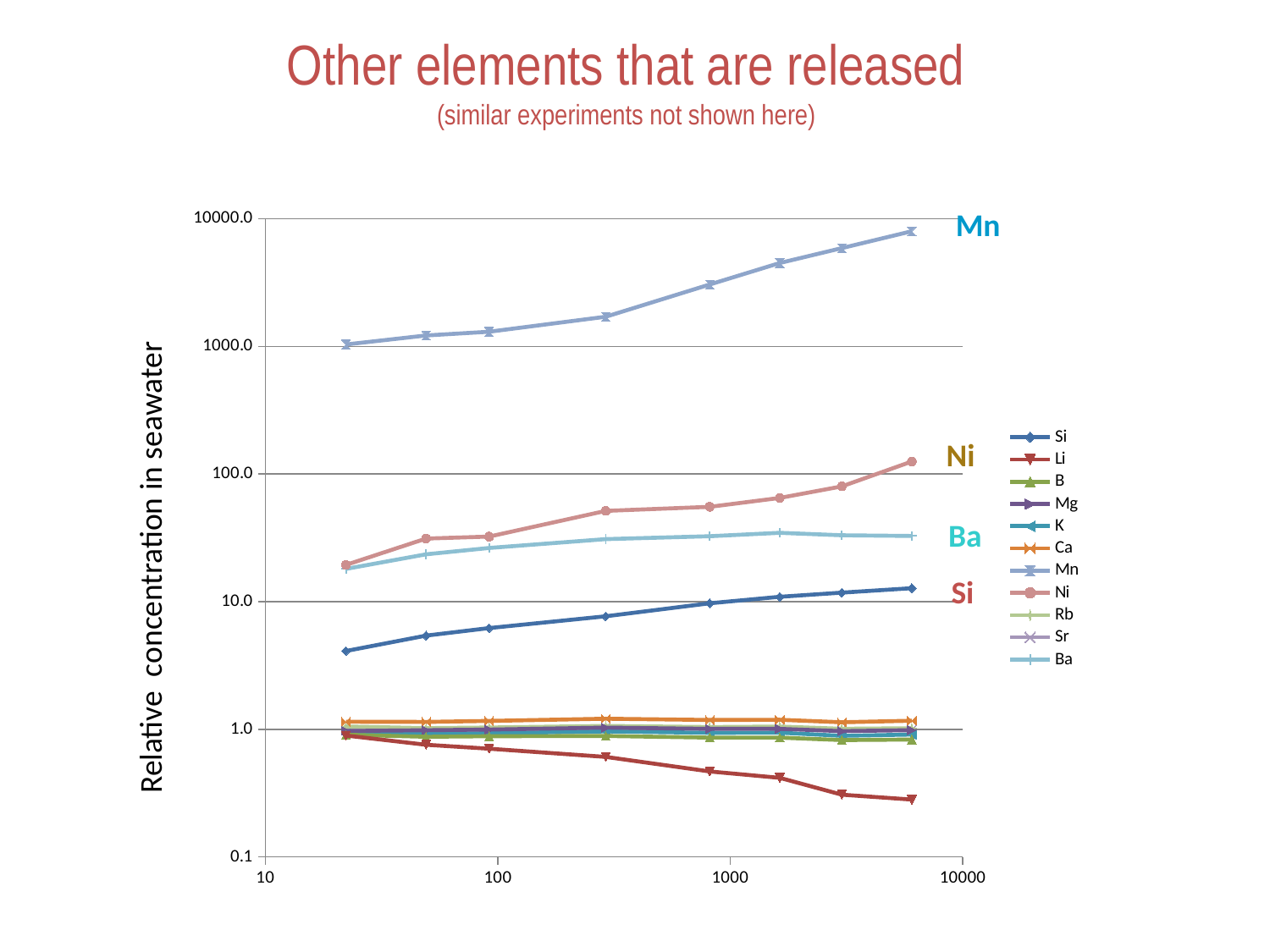
Which series has the highest values across the chart? Mn Do the values for Li rise or fall along the x axis? fall Is the value for Ni at the rightmost point greater or less than 100.0? greater What is the label of the y axis? Relative concentration in seawater Is the value for Li at the rightmost point greater or less than 1.0? less Do the values for Mn rise or fall along the x axis? rise At the rightmost point, which is larger, Ni or Ba? Ni How many series does the legend list? 11 Is the value for Mn at the rightmost point greater or less than 1000.0? greater What kind of chart is shown on the slide? line chart Which series has the lowest value at the right end of the chart? Li